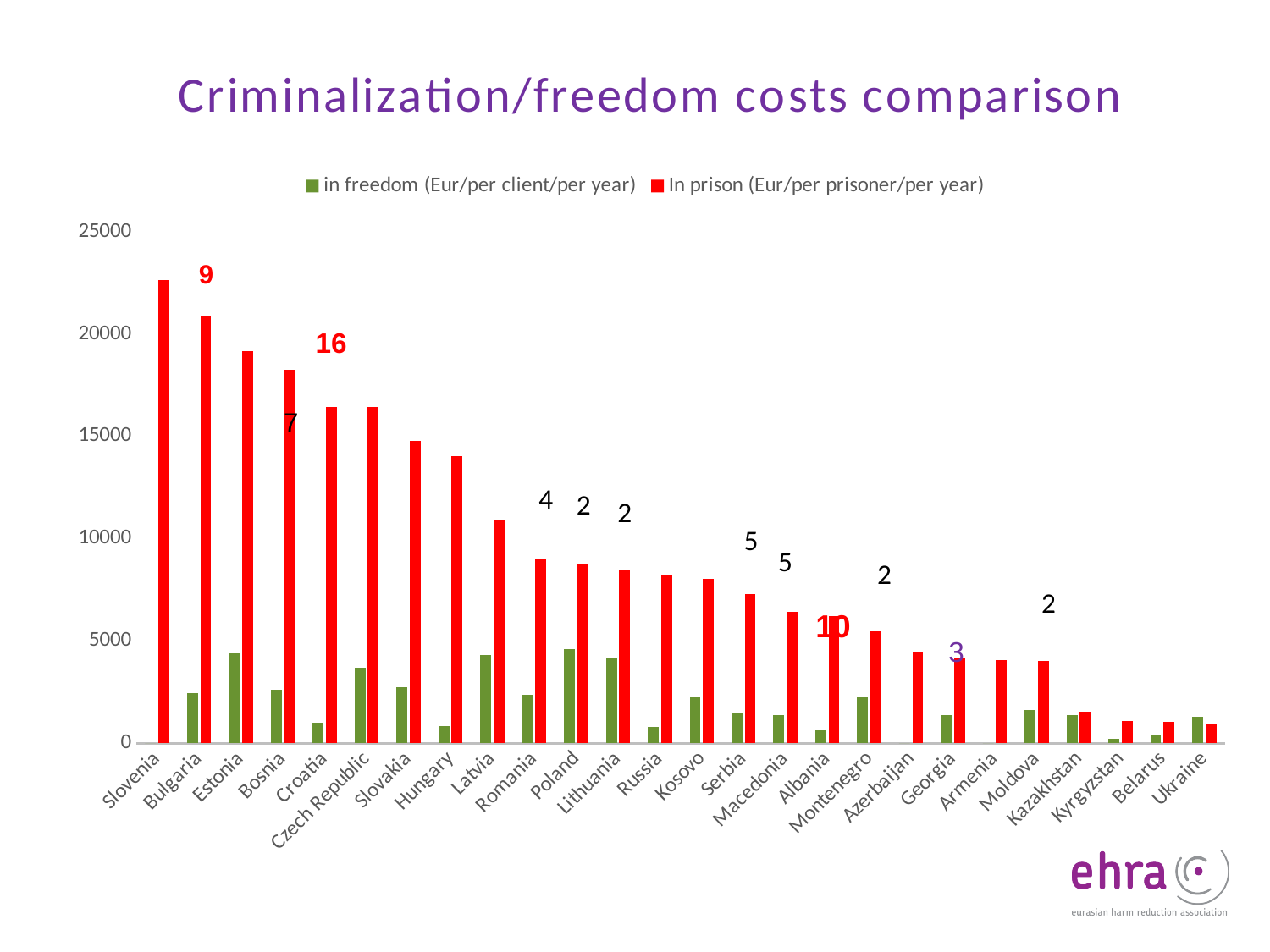
Is the 'in freedom' value for Poland greater or less than 5000? less Which has the larger 'in freedom' value, Poland or Bulgaria? Poland Is the 'In prison' value for Hungary greater or less than 15000? less Which country has the highest 'In prison (Eur/per prisoner/per year)' value? Slovenia Is the 'In prison' value for Slovenia greater or less than 20000? greater How many countries are shown on the x axis? 26 Which has the larger 'In prison' value, Slovenia or Bulgaria? Slovenia What colour are the 'In prison (Eur/per prisoner/per year)' bars? red Do the 'In prison' values generally rise or fall from left to right along the x axis? fall What kind of chart is shown on the slide? bar chart How many series does the legend list? 2